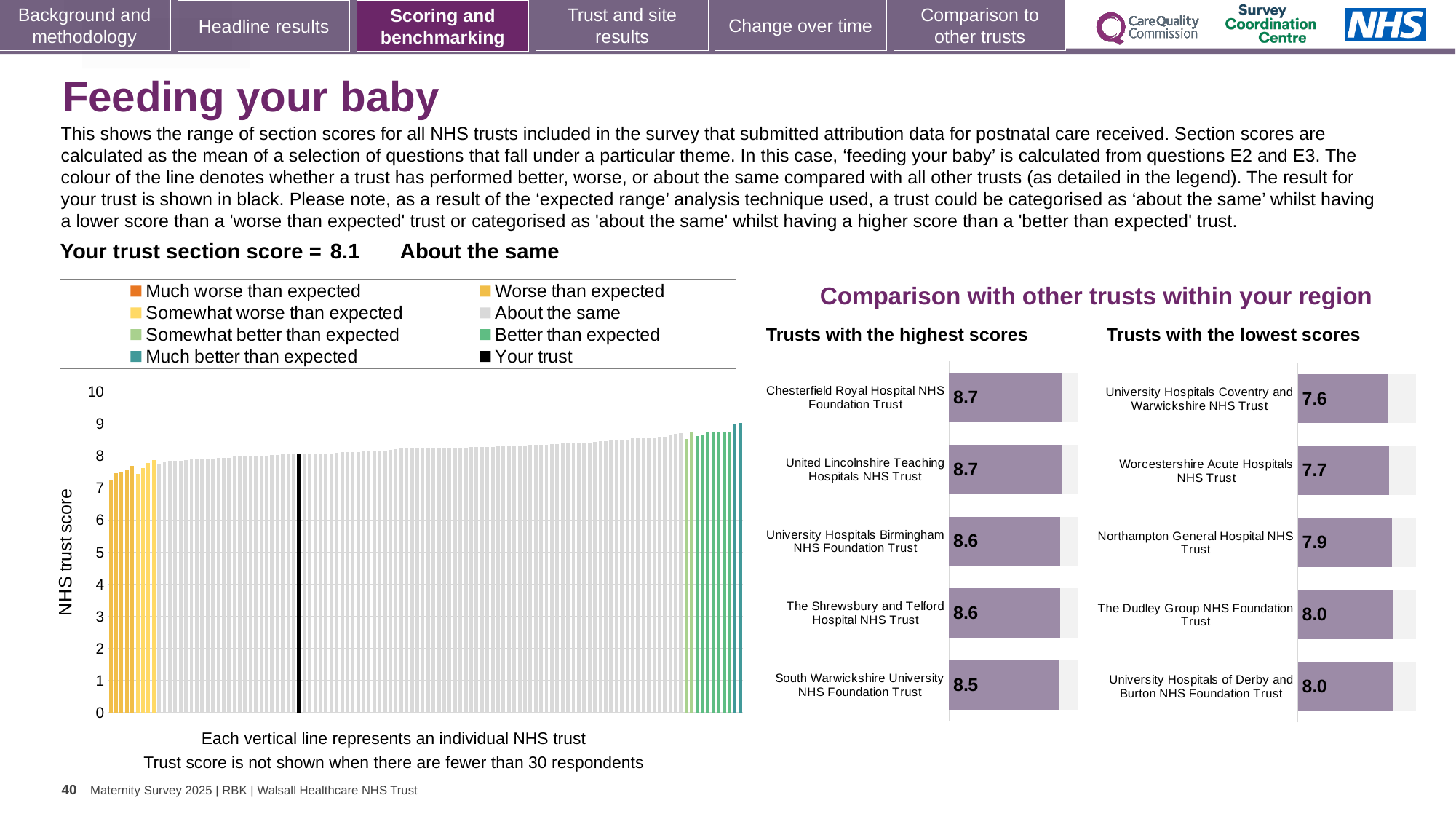
How many trusts are listed in the 'Trusts with the highest scores' chart? 5 In the 'NHS trust score' chart on the left, is the value of the leftmost bar greater or less than 8? less In the 'Trusts with the highest scores' chart, what is the score for Chesterfield Royal Hospital NHS Foundation Trust? 8.7 In the 'NHS trust score' chart on the left, do the values rise or fall from left to right? Rise In the 'Trusts with the lowest scores' chart, what is the difference between the scores of Northampton General Hospital NHS Trust and University Hospitals Coventry and Warwickshire NHS Trust? 0.3 In the 'Trusts with the lowest scores' chart, which trust has the lowest score? University Hospitals Coventry and Warwickshire NHS Trust In the 'Trusts with the highest scores' chart, which trust has the lowest score shown? South Warwickshire University NHS Foundation Trust How many entries does the legend above the 'NHS trust score' chart list? 8 In the 'Trusts with the lowest scores' chart, what is the score for Northampton General Hospital NHS Trust? 7.9 In the 'Trusts with the highest scores' chart, what is the difference between the scores of Chesterfield Royal Hospital NHS Foundation Trust and South Warwickshire University NHS Foundation Trust? 0.2 What kind of chart is the 'NHS trust score' chart on the left of the slide? Bar chart In the 'Trusts with the lowest scores' chart, which has the higher score: Worcestershire Acute Hospitals NHS Trust or The Dudley Group NHS Foundation Trust? The Dudley Group NHS Foundation Trust